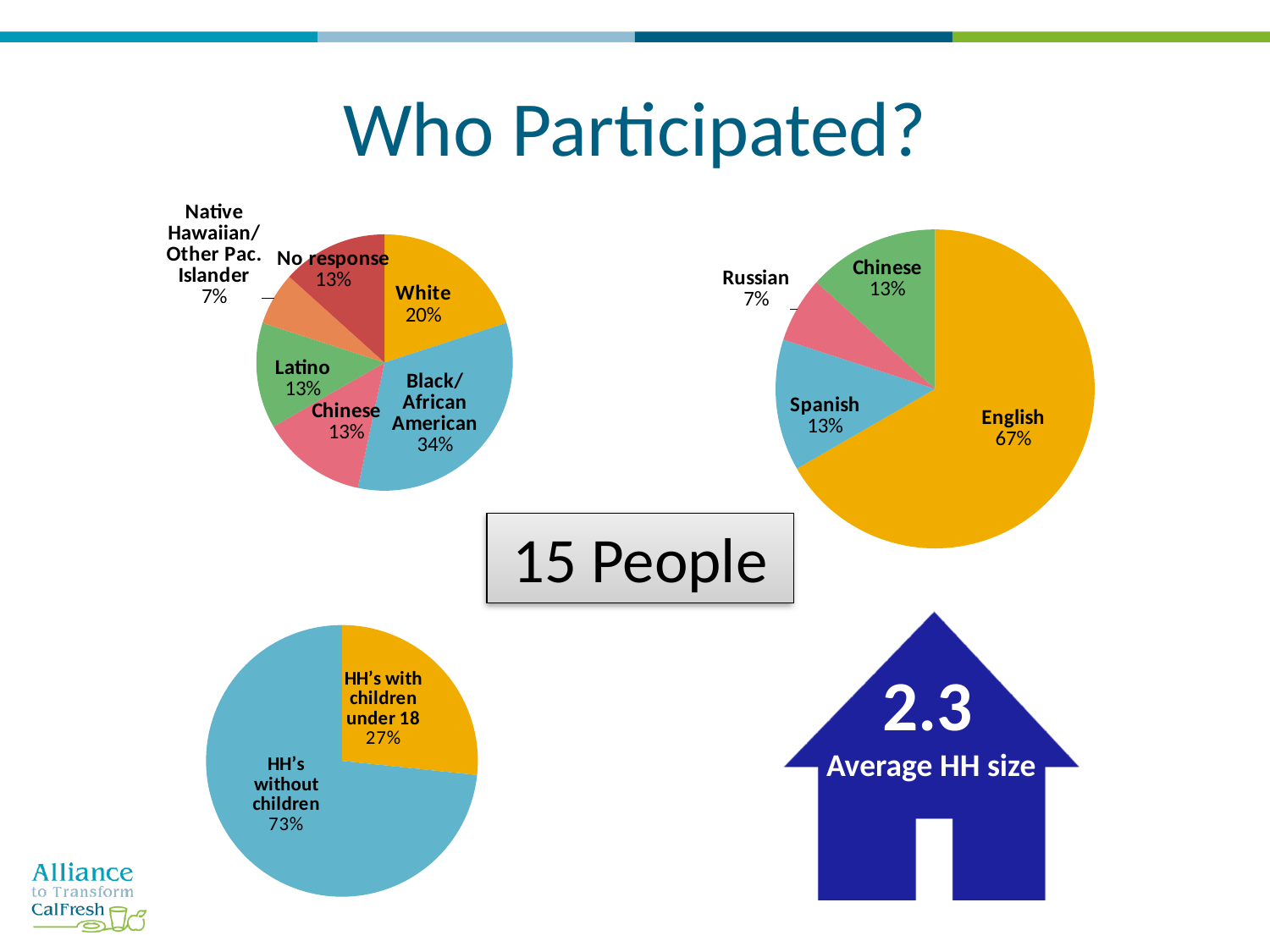
In the bottom-left pie chart, what share is labelled HH's without children? 73% What kind of chart is the bottom-left chart? Pie chart In the top-left pie chart, what share is labelled White? 20% In the top-left pie chart, which category has the largest share? Black/African American In the top-left pie chart, what share is labelled Black/African American? 34% In the top-right pie chart, how many slices are there? 4 In the top-left pie chart, how many slices are there? 6 In the top-right pie chart, what share is labelled Russian? 7% In the top-left pie chart, which category has the smallest share? Native Hawaiian/Other Pac. Islander In the top-left pie chart, what is the difference between the Black/African American share and the White share? 14% In the top-right pie chart, what share is labelled English? 67% In the top-right pie chart, which is larger, Spanish or Russian? Spanish